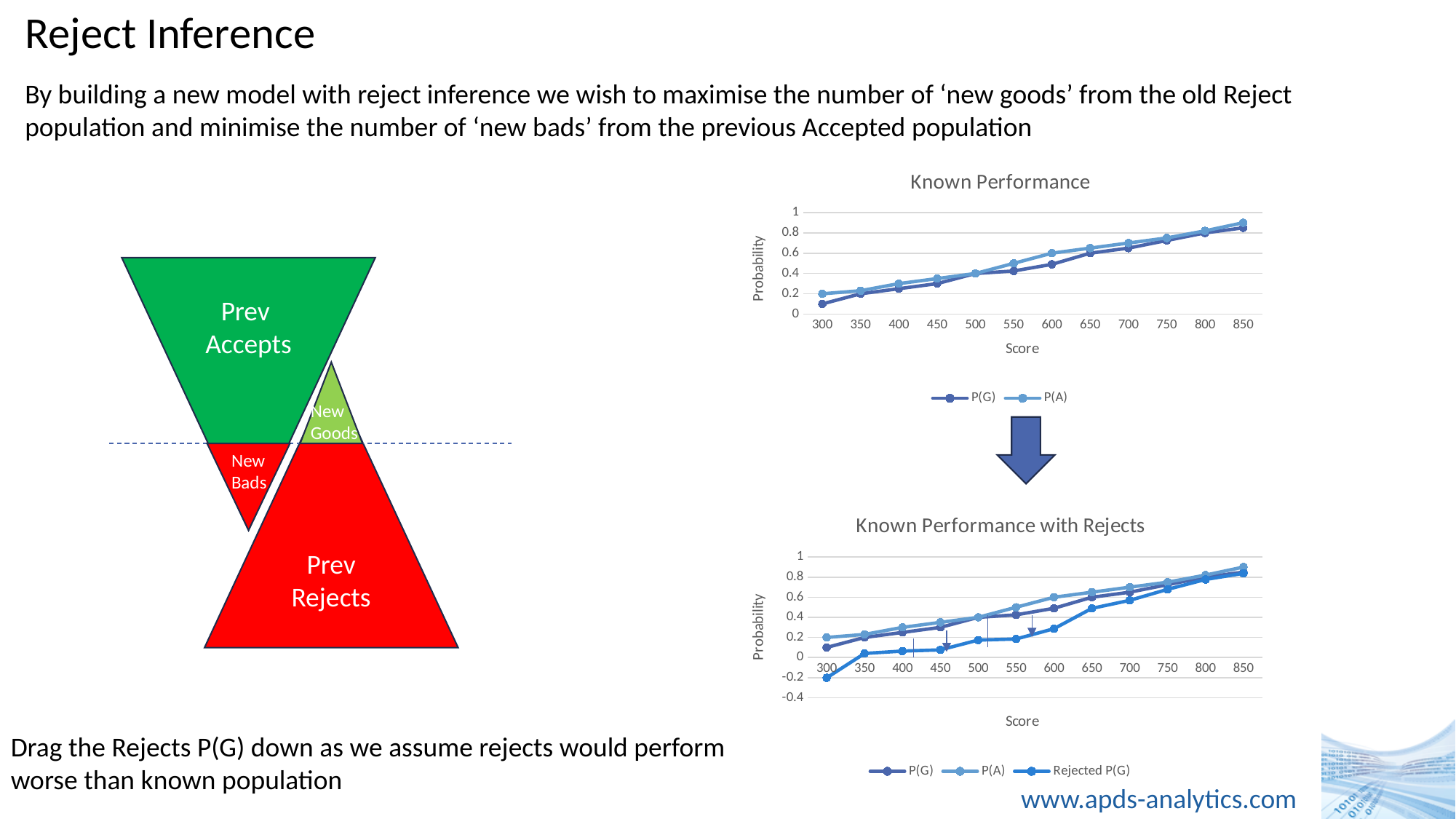
What type of chart is the 'Known Performance' chart? line chart In the 'Known Performance with Rejects' chart, which series has the higher value at a score of 600: P(A) or Rejected P(G)? P(A) In the 'Known Performance' chart, is the P(A) value at a score of 850 greater or less than 0.8? greater What is the label of the x axis on the 'Known Performance' chart? Score What is the label of the y axis on the 'Known Performance with Rejects' chart? Probability How many series does the legend of the 'Known Performance with Rejects' chart list? 3 How many score points are plotted along the x axis of the 'Known Performance' chart? 12 How many series does the legend of the 'Known Performance' chart list? 2 In the 'Known Performance' chart, do the P(G) values rise or fall as the score increases from 300 to 850? rise In the 'Known Performance with Rejects' chart, is the Rejected P(G) value at a score of 300 greater or less than 0? less In the 'Known Performance' chart, is the P(G) value at a score of 300 greater or less than 0.2? less